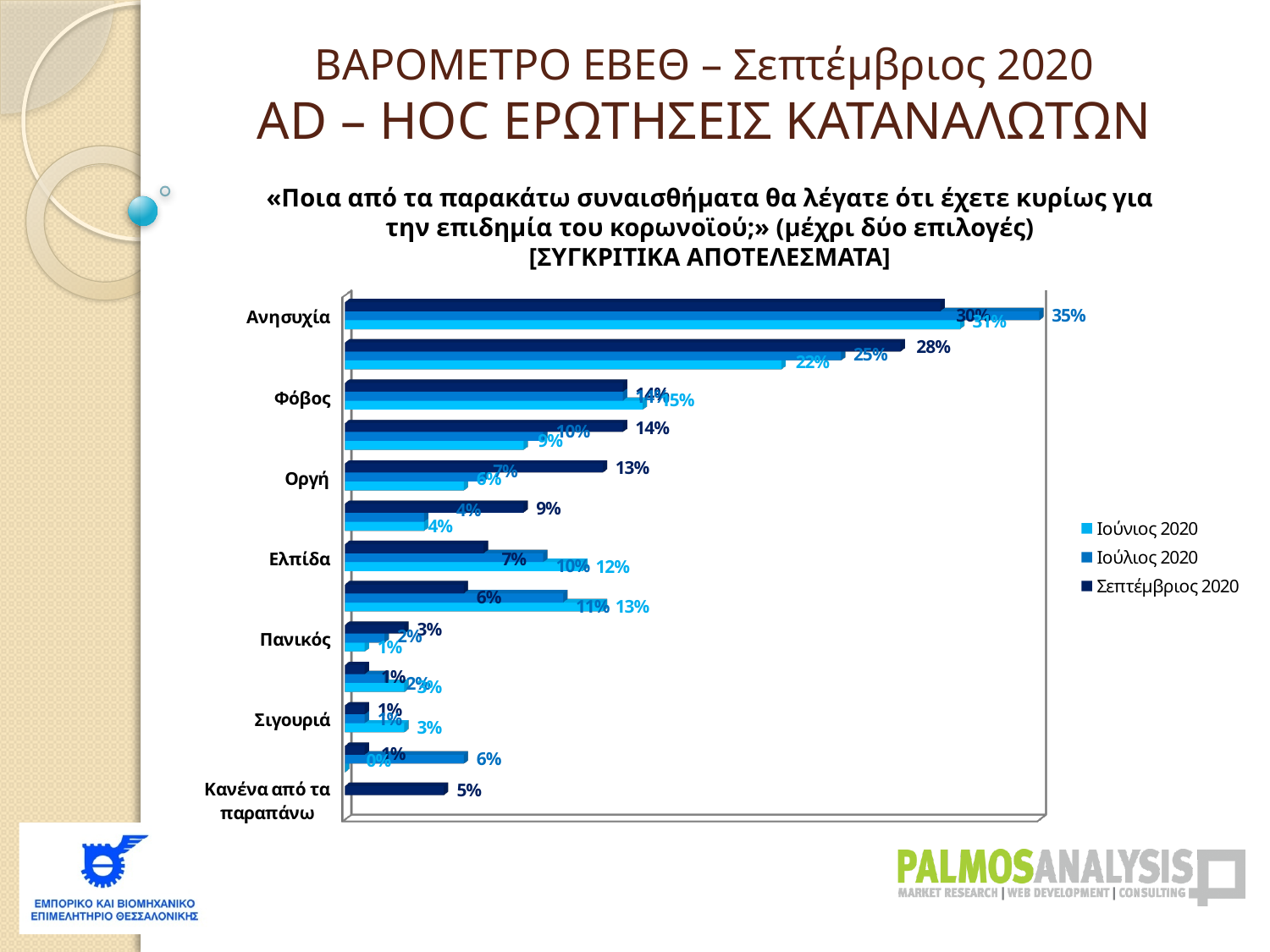
How many series does the legend list? 3 What is the difference between the Ιούλιος 2020 and Σεπτέμβριος 2020 values for Ανησυχία? 5% What is the value for Ανησυχία in the Ιούλιος 2020 series? 35% What kind of chart is shown on the slide? Bar chart What is the value for Ανησυχία in the Σεπτέμβριος 2020 series? 30% Which series is shown in dark navy in the legend? Σεπτέμβριος 2020 What is the value for Σιγουριά in the Ιούνιος 2020 series? 3% For Οργή, which series has the larger value: Σεπτέμβριος 2020 or Ιούλιος 2020? Σεπτέμβριος 2020 What is the value for Οργή in the Σεπτέμβριος 2020 series? 13% What is the value for Ελπίδα in the Ιούλιος 2020 series? 10% Which category has the highest value in the Σεπτέμβριος 2020 series? Ανησυχία What is the value for Κανένα από τα παραπάνω in the Σεπτέμβριος 2020 series? 5%